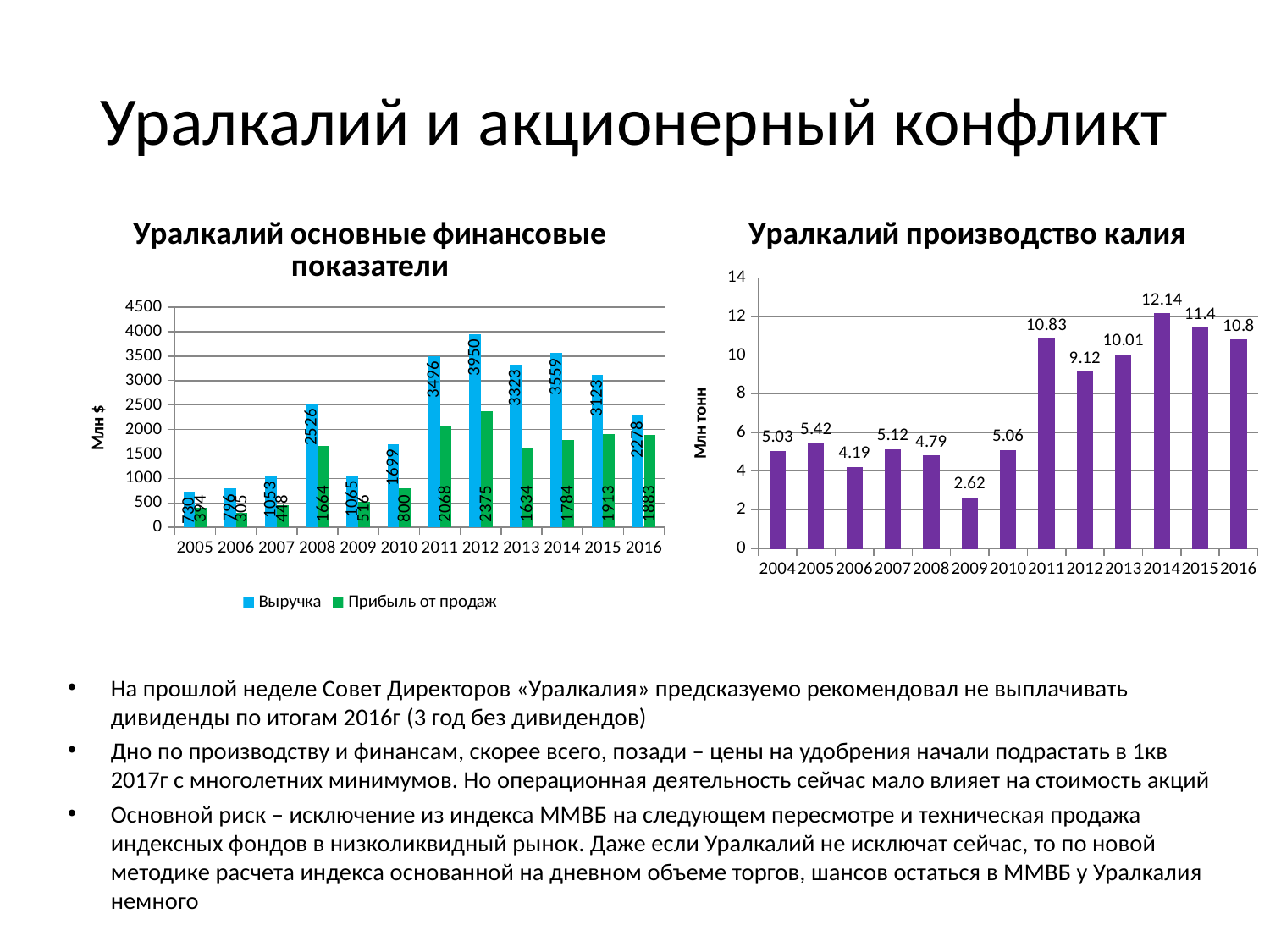
In the chart 'Уралкалий производство калия', which year has the lowest value? 2009 What kind of chart is 'Уралкалий производство калия'? Bar chart In the chart 'Уралкалий производство калия', which year has the highest value? 2014 In the chart 'Уралкалий производство калия', how many years are shown on the x axis? 13 In the chart 'Уралкалий основные финансовые показатели', which year has the highest Выручка? 2012 In the chart 'Уралкалий основные финансовые показатели', what is the value of Выручка for 2012? 3950 In the chart 'Уралкалий производство калия', what is the difference between the values for 2011 and 2012? 1.71 In the chart 'Уралкалий производство калия', what is the value for 2014? 12.14 In the chart 'Уралкалий основные финансовые показатели', which is larger: Выручка in 2008 or Выручка in 2010? Выручка in 2008 In the chart 'Уралкалий основные финансовые показатели', how many series does the legend list? 2 In the chart 'Уралкалий основные финансовые показатели', what is the difference between Выручка and Прибыль от продаж in 2015? 1210 In the chart 'Уралкалий основные финансовые показатели', what is the value of Прибыль от продаж for 2016? 1883